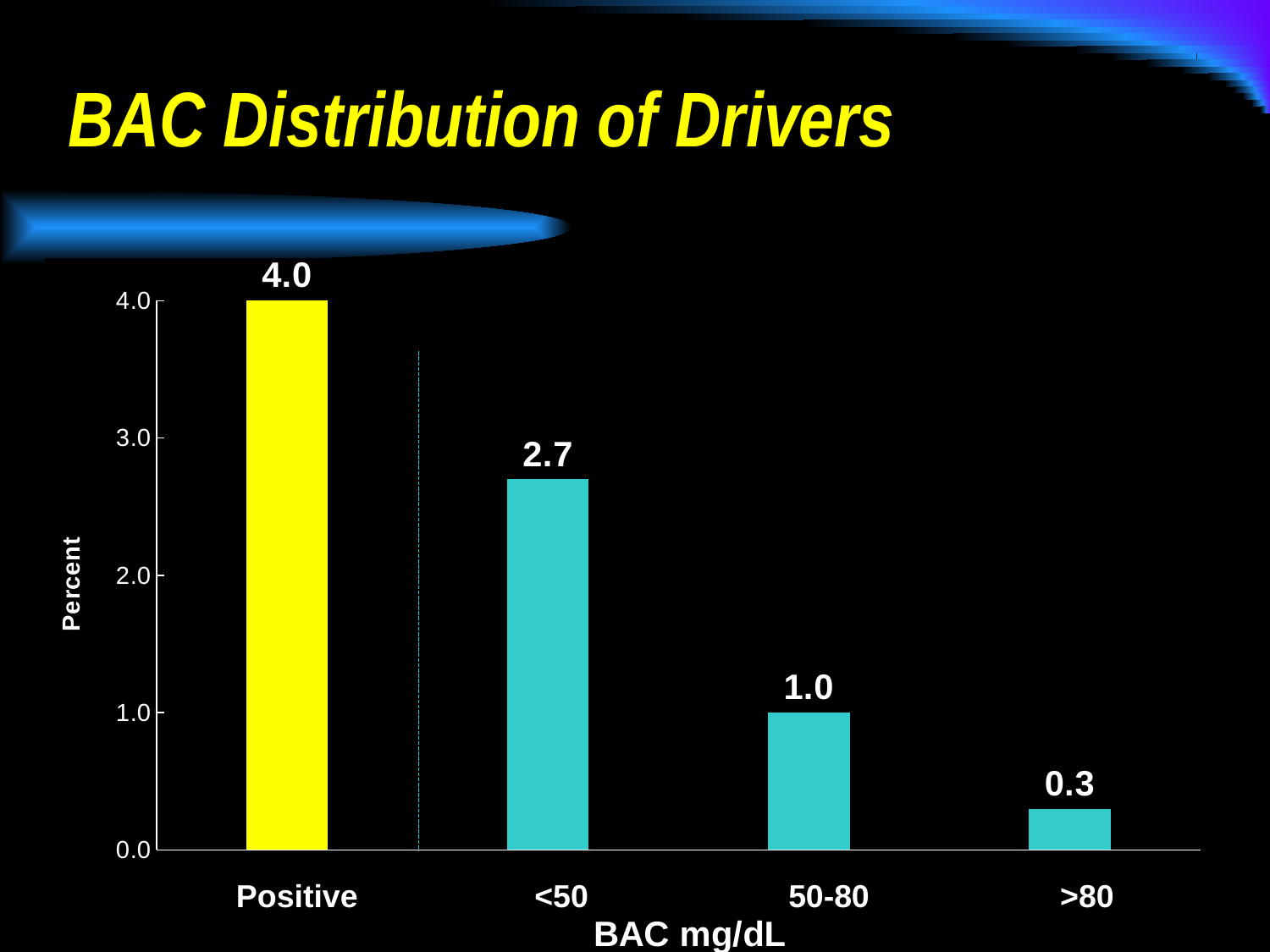
Which is larger, the value for 50-80 or the value for >80? 50-80 What is the value for the Positive category? 4.0 What is the difference between the values for <50 and 50-80? 1.7 What kind of chart is shown on the slide? Bar chart Which category has the highest value? Positive What is the value for the >80 BAC category? 0.3 What is the difference between the values for Positive and <50? 1.3 How many categories are shown on the x axis? 4 What is the label of the y axis? Percent What is the value for the <50 BAC category? 2.7 Which category has the lowest value? >80 What is the value for the 50-80 BAC category? 1.0